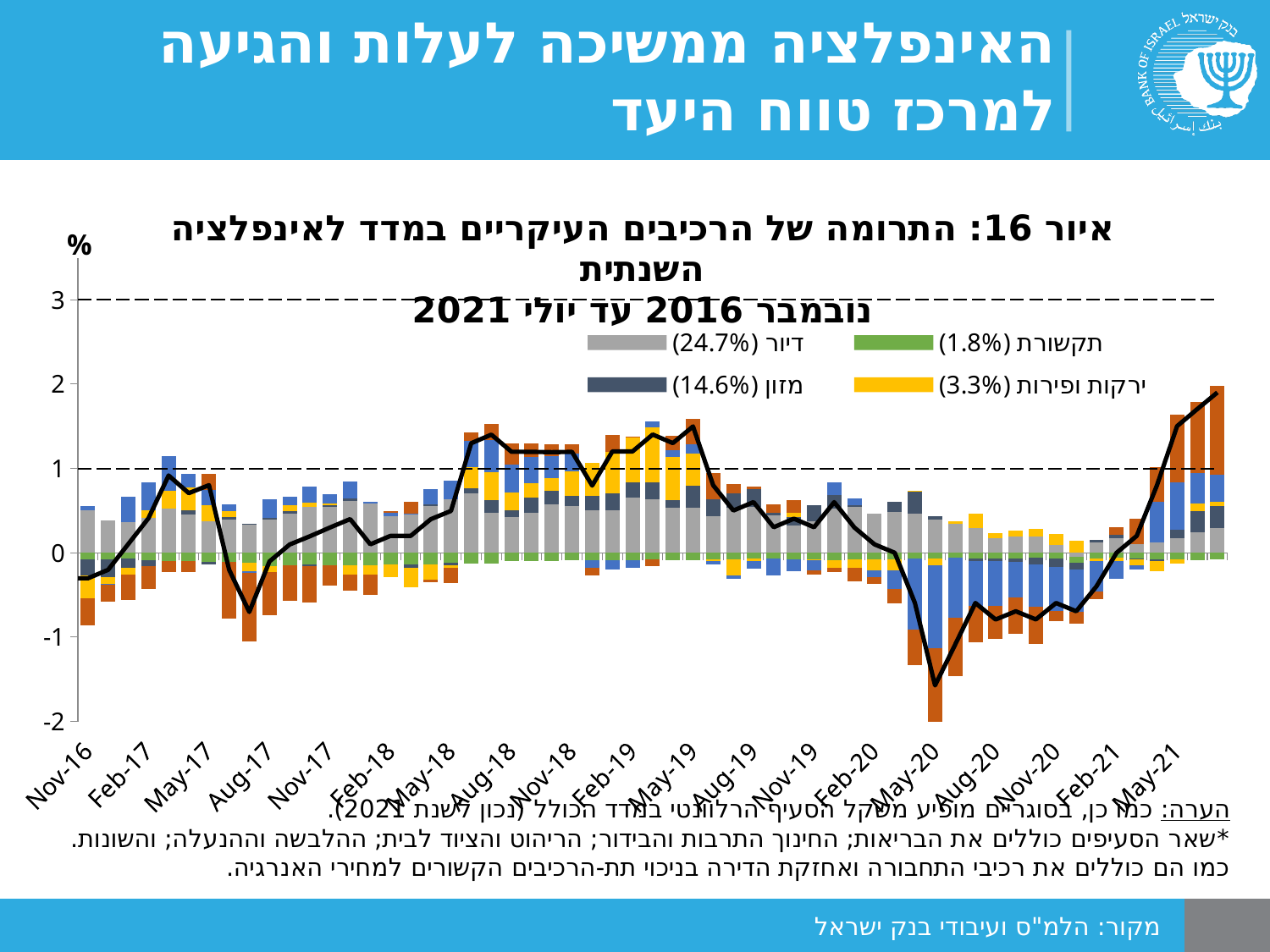
What is the weight shown in the legend for דיור (housing)? 24.7% What is the weight shown in the legend for ירקות ופירות (vegetables and fruit)? 3.3% At which x-axis label does the black line reach its lowest point? May-20 What kind of chart is shown on the slide? Stacked bar chart with a line Does the black line rise or fall between Feb-21 and the end of the series? rise Is the value of the black line at May-20 greater or less than -1? less How many series are listed in the visible legend? 4 Is the value of the black line at the last point (Jul-21) greater or less than 1? greater What is the unit shown at the top of the y axis? % What is the weight shown in the legend for מזון (food)? 14.6% What is the weight shown in the legend for תקשורת (communications)? 1.8%